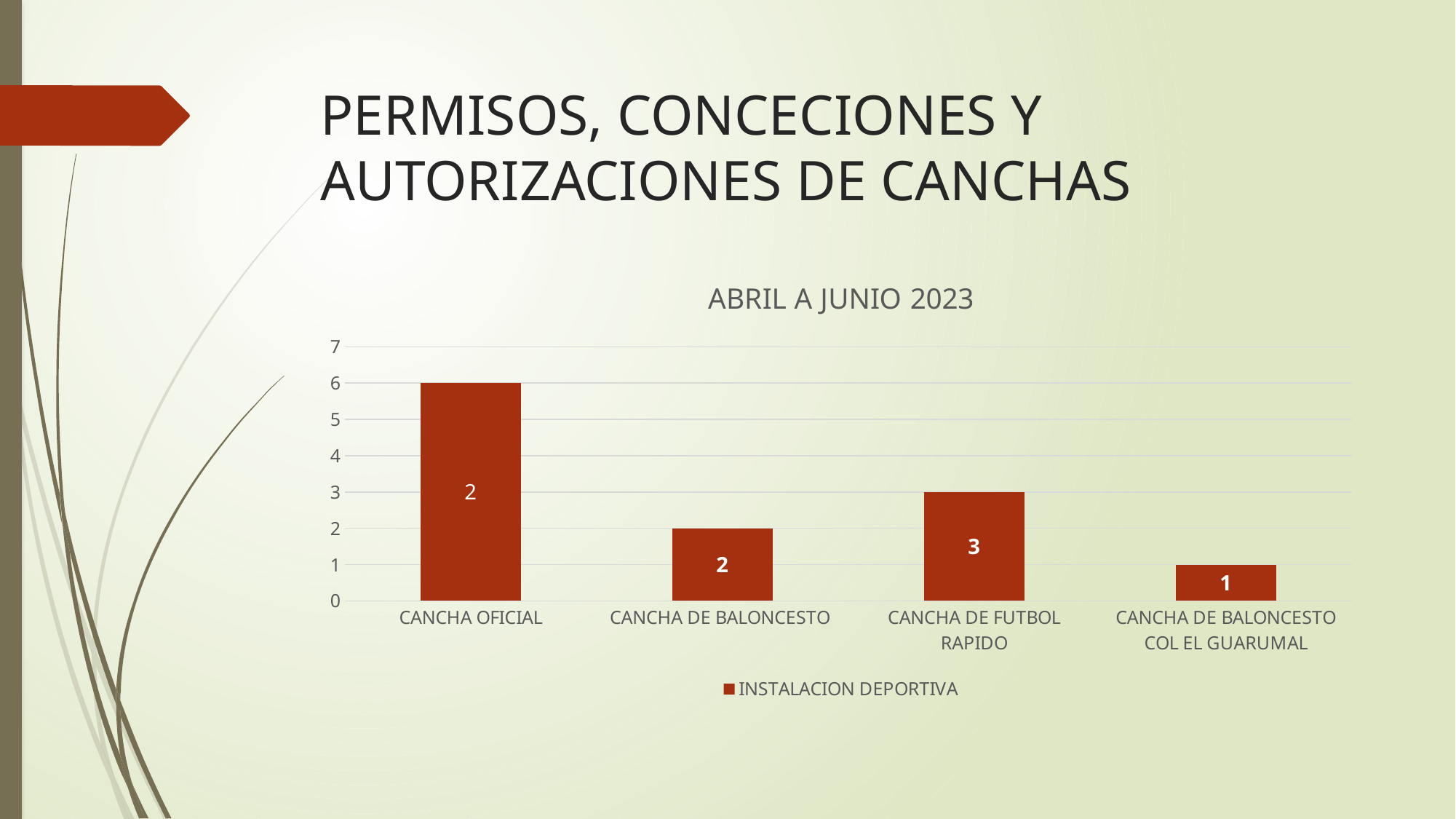
What is the value for CANCHA DE FUTBOL RAPIDO? 3 Which category has the tallest bar? CANCHA OFICIAL Which is larger, the value for CANCHA DE FUTBOL RAPIDO or the value for CANCHA DE BALONCESTO? CANCHA DE FUTBOL RAPIDO What type of chart is shown on the slide? Bar chart How many series does the legend list? 1 What is the title of the chart? ABRIL A JUNIO 2023 Which category has the lowest value? CANCHA DE BALONCESTO COL EL GUARUMAL What is the value for CANCHA DE BALONCESTO? 2 How many categories are shown on the x axis? 4 What is the value for CANCHA DE BALONCESTO COL EL GUARUMAL? 1 What is the difference between the values for CANCHA DE FUTBOL RAPIDO and CANCHA DE BALONCESTO? 1 What is the difference between the values for CANCHA DE FUTBOL RAPIDO and CANCHA DE BALONCESTO COL EL GUARUMAL? 2